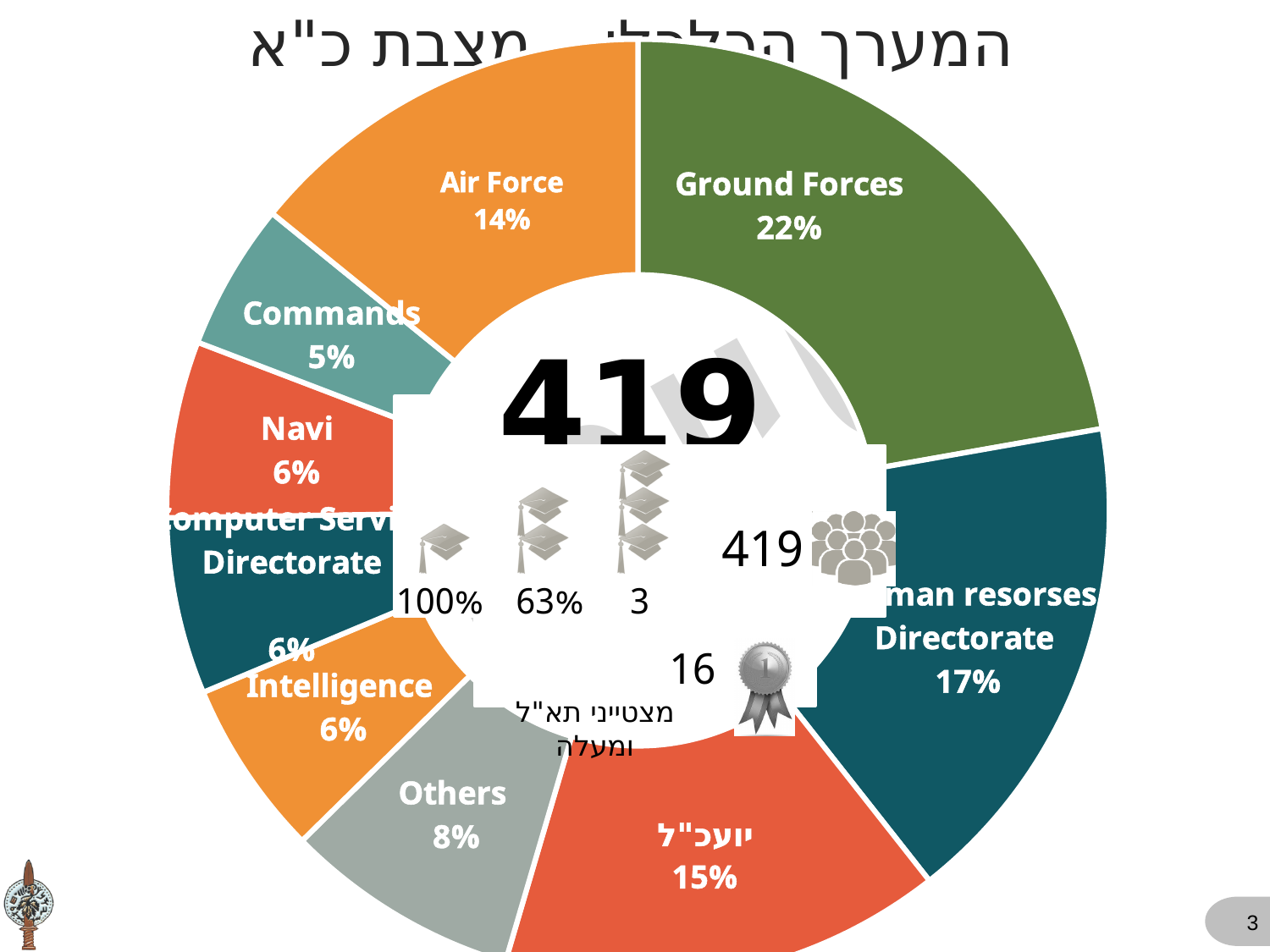
What is the difference in percentage points between Ground Forces and Air Force? 8 How many segments does the doughnut chart have? 9 What kind of chart is shown on the slide? Doughnut (pie) chart Which segment is larger, Air Force or Others? Air Force Which segment has the largest share of the chart? Ground Forces What percentage does the Air Force segment show? 14% What percentage does the Commands segment show? 5% What percentage does the Intelligence segment show? 6% What percentage does the Ground Forces segment show? 22% Which segment has the smallest share of the chart? Commands What large number is displayed in the centre of the doughnut chart? 419 What percentage does the Others segment show? 8%